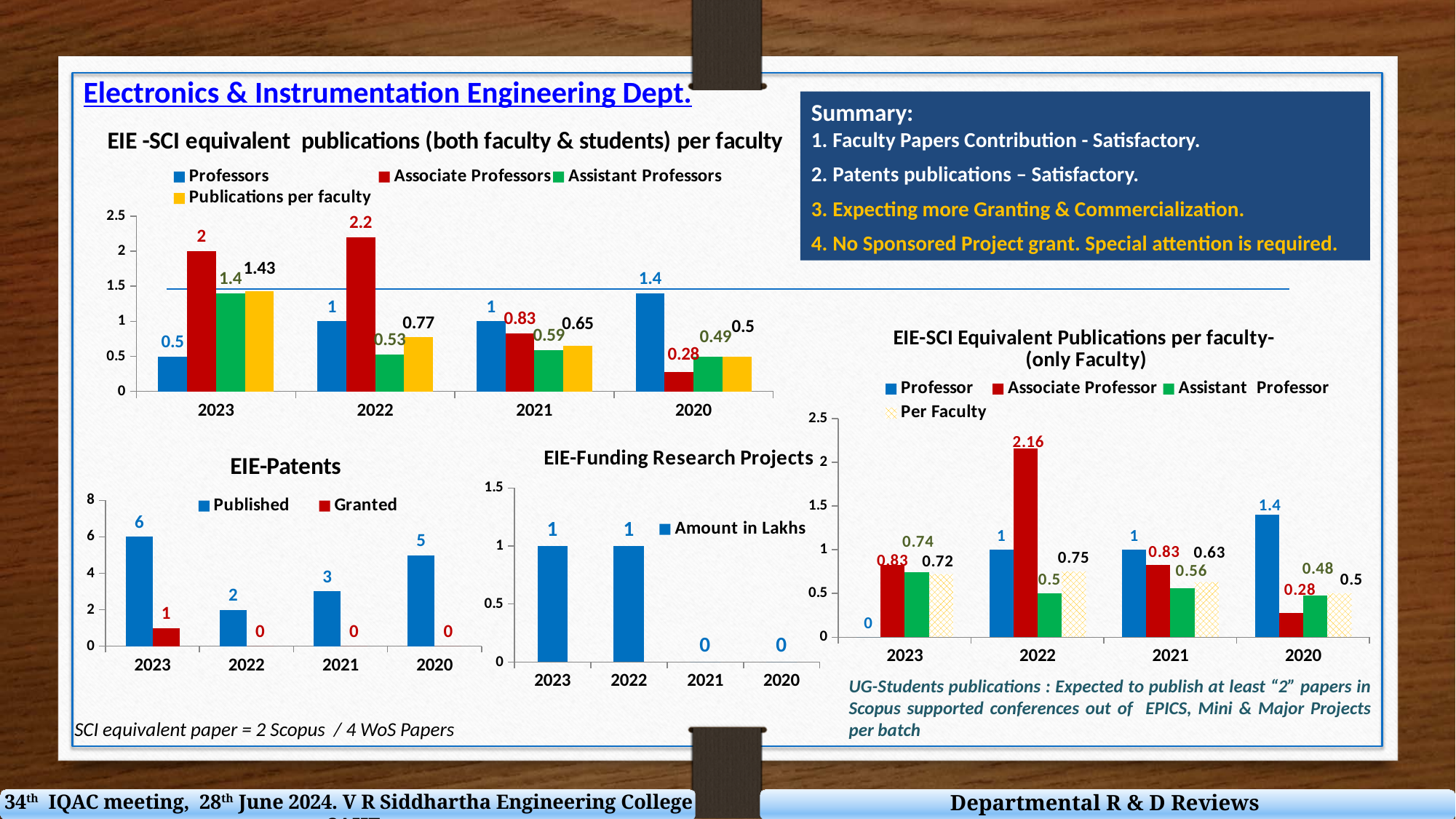
In the 'EIE -SCI equivalent publications (both faculty & students) per faculty' chart, how many series does the legend list? 4 In the 'EIE -SCI equivalent publications (both faculty & students) per faculty' chart, what is the Publications per faculty value for 2023? 1.43 In the 'EIE-SCI Equivalent Publications per faculty- (only Faculty)' chart, what is the value for Associate Professor in 2022? 2.16 In the 'EIE-Patents' chart, which year has the lowest number of Published patents? 2022 What kind of chart is 'EIE-Funding Research Projects'? Bar chart In the 'EIE-SCI Equivalent Publications per faculty- (only Faculty)' chart, how many years are shown on the x axis? 4 In the 'EIE -SCI equivalent publications (both faculty & students) per faculty' chart, which year has the highest value for Professors? 2020 In the 'EIE -SCI equivalent publications (both faculty & students) per faculty' chart, what is the value for Associate Professors in 2022? 2.2 In the 'EIE-Funding Research Projects' chart, what is the Amount in Lakhs for 2021? 0 In the 'EIE-SCI Equivalent Publications per faculty- (only Faculty)' chart, which is larger in 2021: Professor or Assistant Professor? Professor In the 'EIE-Patents' chart, what is the difference between Published and Granted patents in 2023? 5 In the 'EIE-Patents' chart, how many patents were Published in 2023? 6